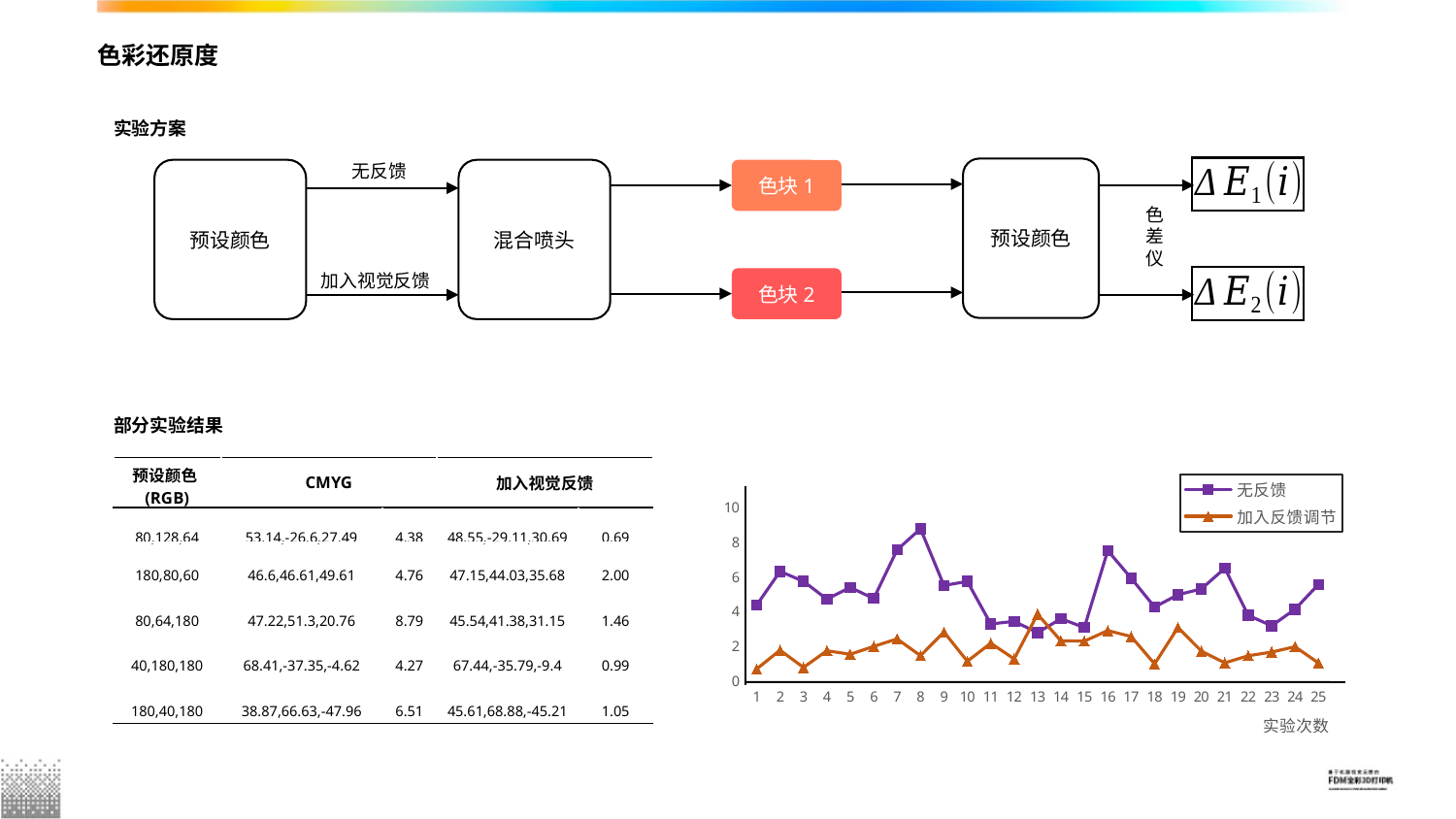
Is the value of 加入反馈调节 at experiment 1 greater or less than 2? less What kind of chart is shown on the slide? line chart At experiment 8, which series has the larger value, 无反馈 or 加入反馈调节? 无反馈 What are the two series named in the chart's legend? 无反馈 and 加入反馈调节 At which experiment number does the 无反馈 series reach its highest value? 8 How many series does the chart's legend list? 2 How many experiment numbers (points) are plotted along the x axis of the chart? 25 Which series is plotted with orange triangle markers? 加入反馈调节 At which experiment number does the 加入反馈调节 series reach its highest value? 13 What is the label of the chart's x axis? 实验次数 Is the value of 无反馈 at experiment 16 greater or less than 6? greater Is the value of 无反馈 at experiment 8 greater or less than 8? greater